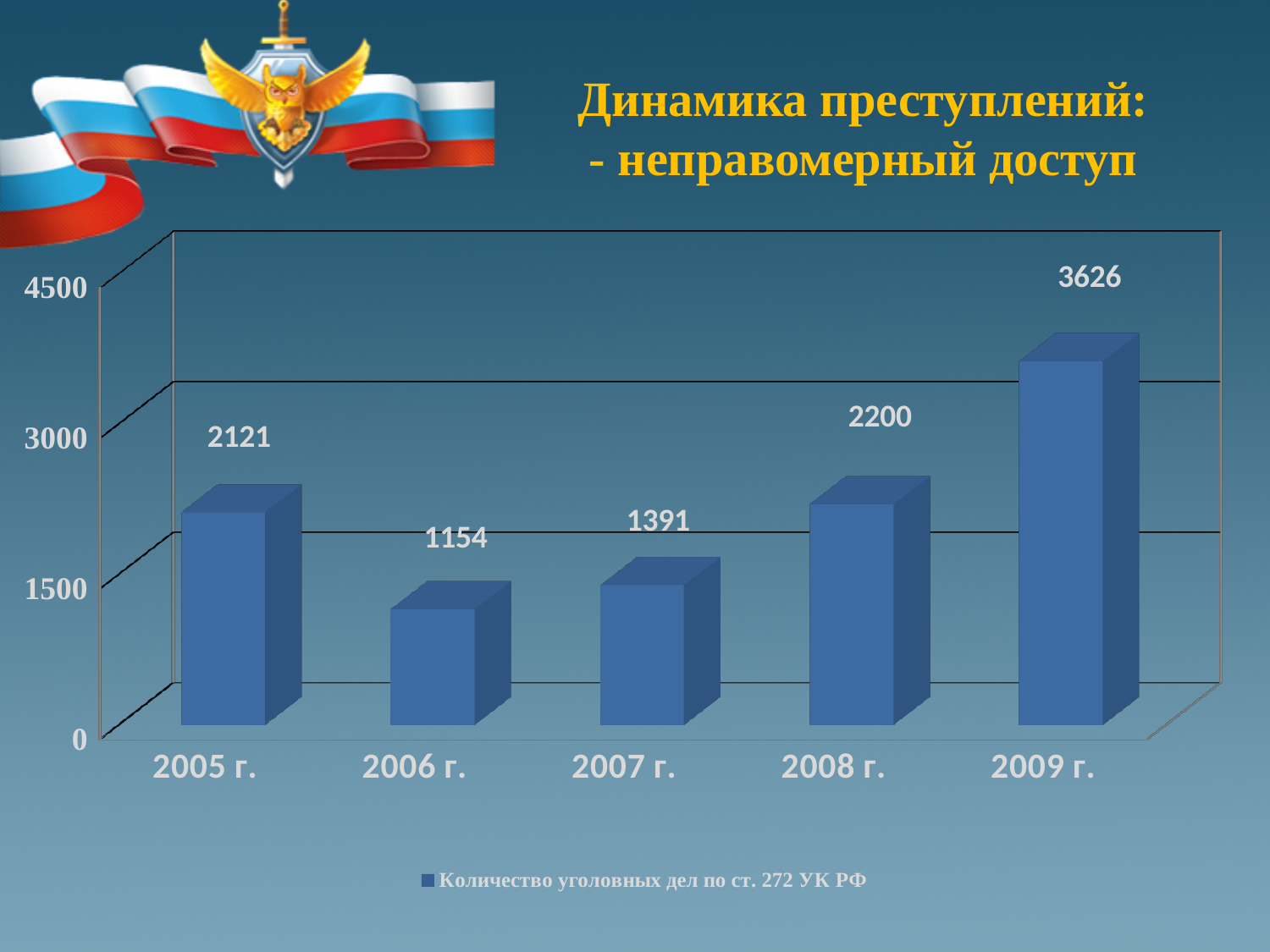
Which year has the highest value? 2009 г. Is the value for 2007 г. greater or less than 1500? less Which is larger, the value for 2005 г. or the value for 2008 г.? 2008 г. What is the difference between the values for 2009 г. and 2008 г.? 1426 How many years are shown on the x axis? 5 What is the value for 2006 г.? 1154 What is the value for 2009 г.? 3626 Which year has the lowest value? 2006 г. What series name does the legend show? Количество уголовных дел по ст. 272 УК РФ What is the difference between the values for 2007 г. and 2006 г.? 237 What kind of chart is shown on the slide? bar chart What is the value for 2005 г.? 2121